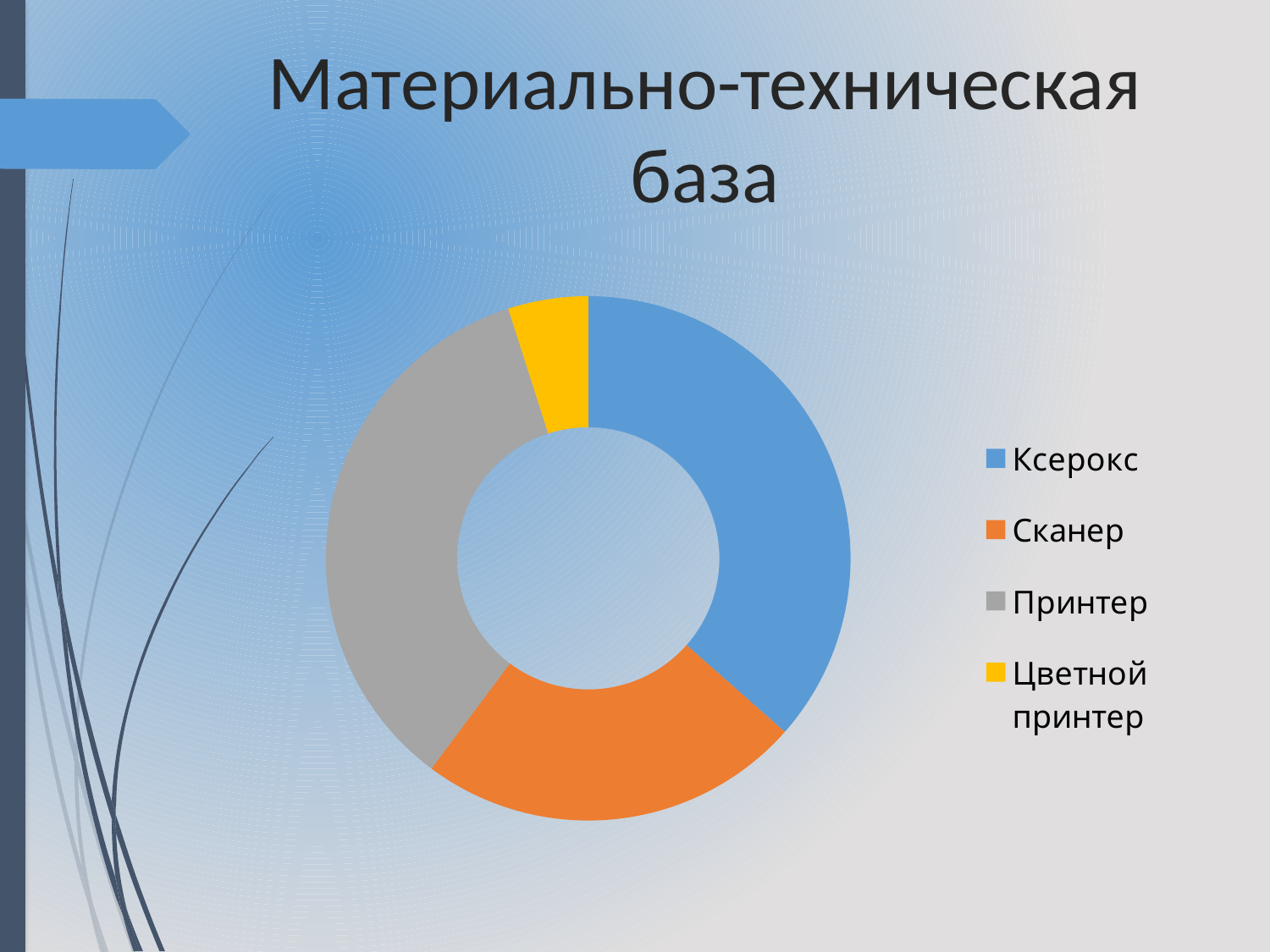
Which category has the largest share of the chart? Ксерокс Which is larger: the share for Сканер or the share for Принтер? Принтер Which category has the smallest share of the chart? Цветной принтер Which is larger: the share for Сканер or the share for Цветной принтер? Сканер What colour represents Принтер in the chart? Gray What is the title of the slide with the chart? Материально-техническая база Which category is shown in orange? Сканер What kind of chart is shown on the slide? Doughnut (pie) chart How many categories does the chart show? 4 Which is larger: the share for Ксерокс or the share for Цветной принтер? Ксерокс